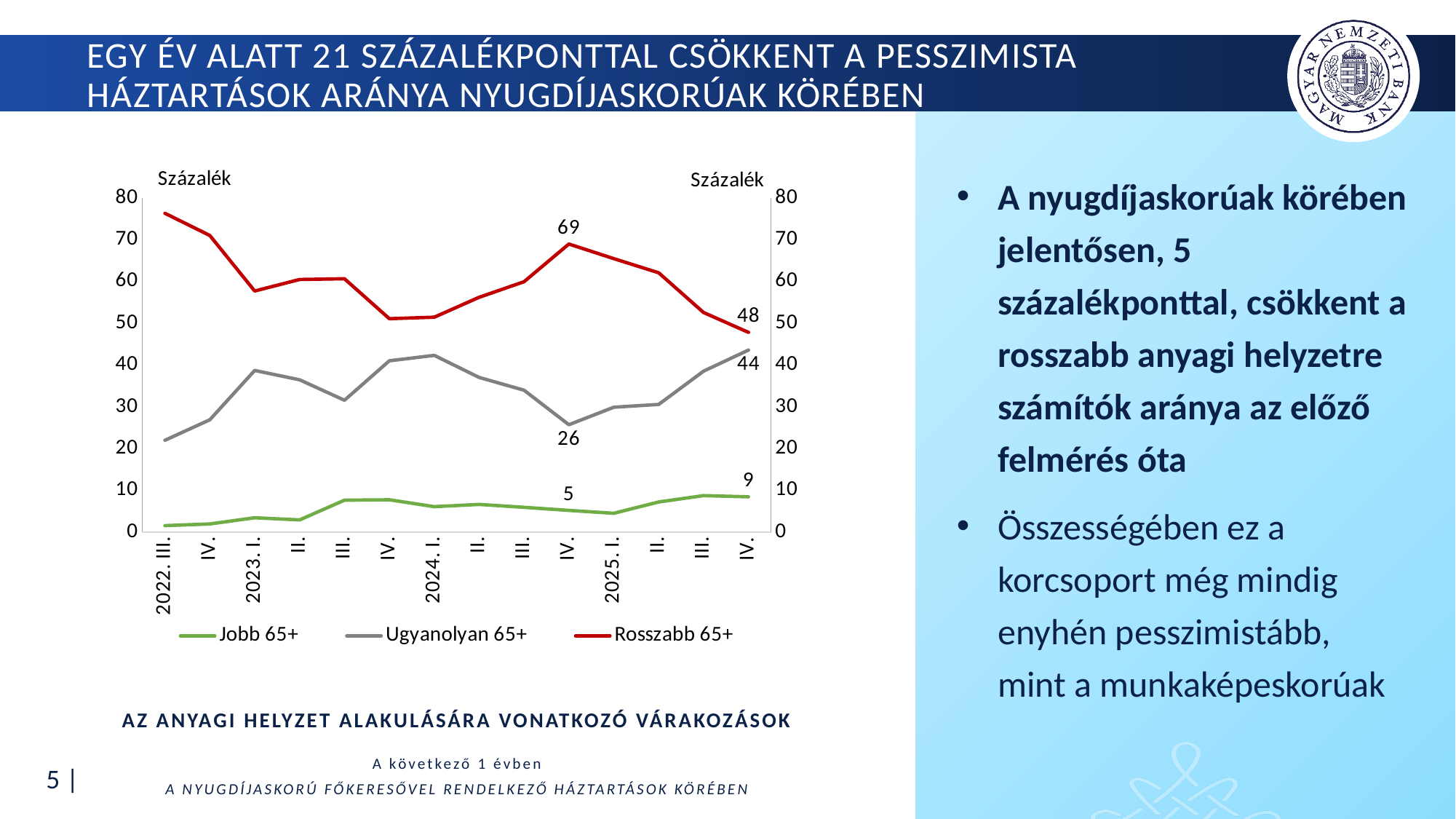
How many series does the legend list? 3 By how much did the Rosszabb 65+ series fall from 2024. IV. to 2025. IV.? 21 What is the value of the Rosszabb 65+ series at 2025. IV.? 48 What kind of chart is shown on the slide? line chart Is the value of the Ugyanolyan 65+ series at 2022. III. greater or less than 30? less Is the value of the Rosszabb 65+ series at 2022. III. greater or less than 70? greater What is the difference between the Ugyanolyan 65+ values at 2025. IV. and 2024. IV.? 18 What is the value of the Ugyanolyan 65+ series at 2025. IV.? 44 Does the Rosszabb 65+ series rise or fall between 2024. IV. and 2025. IV.? fall At 2025. IV., which series has the larger value: Rosszabb 65+ or Ugyanolyan 65+? Rosszabb 65+ What is the value of the Rosszabb 65+ series at 2024. IV.? 69 What is the value of the Jobb 65+ series at 2025. IV.? 9